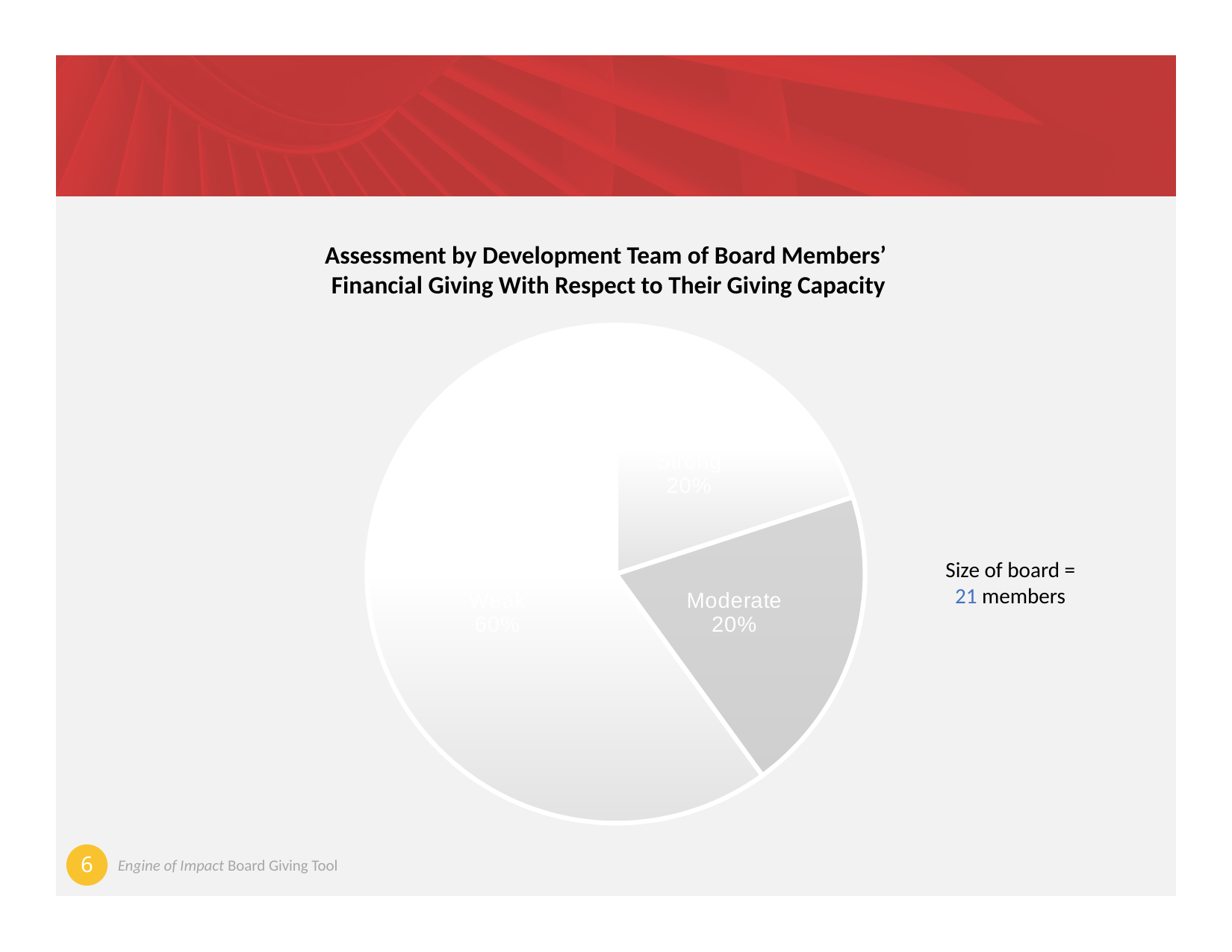
By how many percentage points does the Weak slice exceed the Moderate slice? 40 percentage points How many slices does the pie chart have? 3 What percentage of the pie is labelled Strong? 20% What is the title of the chart? Assessment by Development Team of Board Members' Financial Giving With Respect to Their Giving Capacity What kind of chart is shown on the slide? pie chart What share of the pie does the Weak slice represent? 60% Which slice is larger, Weak or Moderate? Weak Which slice of the pie chart is the largest? Weak According to the text next to the chart, how many members are on the board? 21 members Is the value for Weak greater or less than 50%? greater What percentage of the pie is labelled Weak? 60% What percentage of the pie is labelled Moderate? 20%